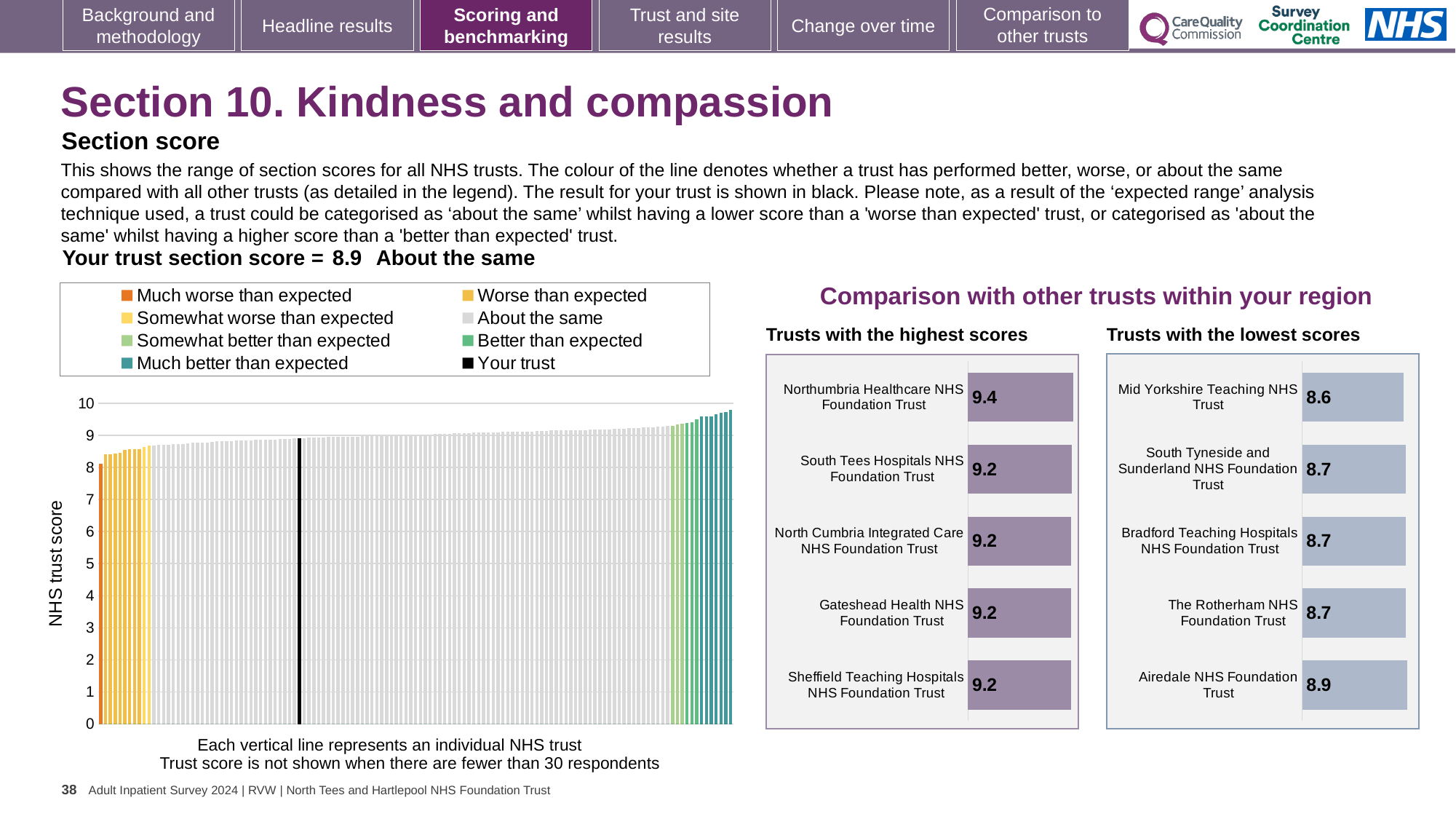
How many entries does the legend of the large chart on the left list? 8 In the 'Trusts with the highest scores' chart, what is the score for Gateshead Health NHS Foundation Trust? 9.2 In the 'Trusts with the lowest scores' chart, what is the score for Airedale NHS Foundation Trust? 8.9 In the 'Trusts with the lowest scores' chart, what is the score for Mid Yorkshire Teaching NHS Trust? 8.6 Which is larger: the score for Northumbria Healthcare NHS Foundation Trust in the highest-scores chart or the score for Airedale NHS Foundation Trust in the lowest-scores chart? Northumbria Healthcare NHS Foundation Trust In the 'Trusts with the highest scores' chart, what is the difference between the scores of Northumbria Healthcare NHS Foundation Trust and South Tees Hospitals NHS Foundation Trust? 0.2 In the 'Trusts with the highest scores' chart, which trust has the highest score? Northumbria Healthcare NHS Foundation Trust In the 'Trusts with the highest scores' chart, what is the score for Northumbria Healthcare NHS Foundation Trust? 9.4 How many trusts are shown in the 'Trusts with the lowest scores' chart? 5 In the 'Trusts with the lowest scores' chart, what is the difference between the scores of Airedale NHS Foundation Trust and Mid Yorkshire Teaching NHS Trust? 0.3 In the 'Trusts with the lowest scores' chart, which trust has the lowest score? Mid Yorkshire Teaching NHS Trust In the large chart on the left showing NHS trust scores, is the value of the black bar for your trust greater or less than 8? greater